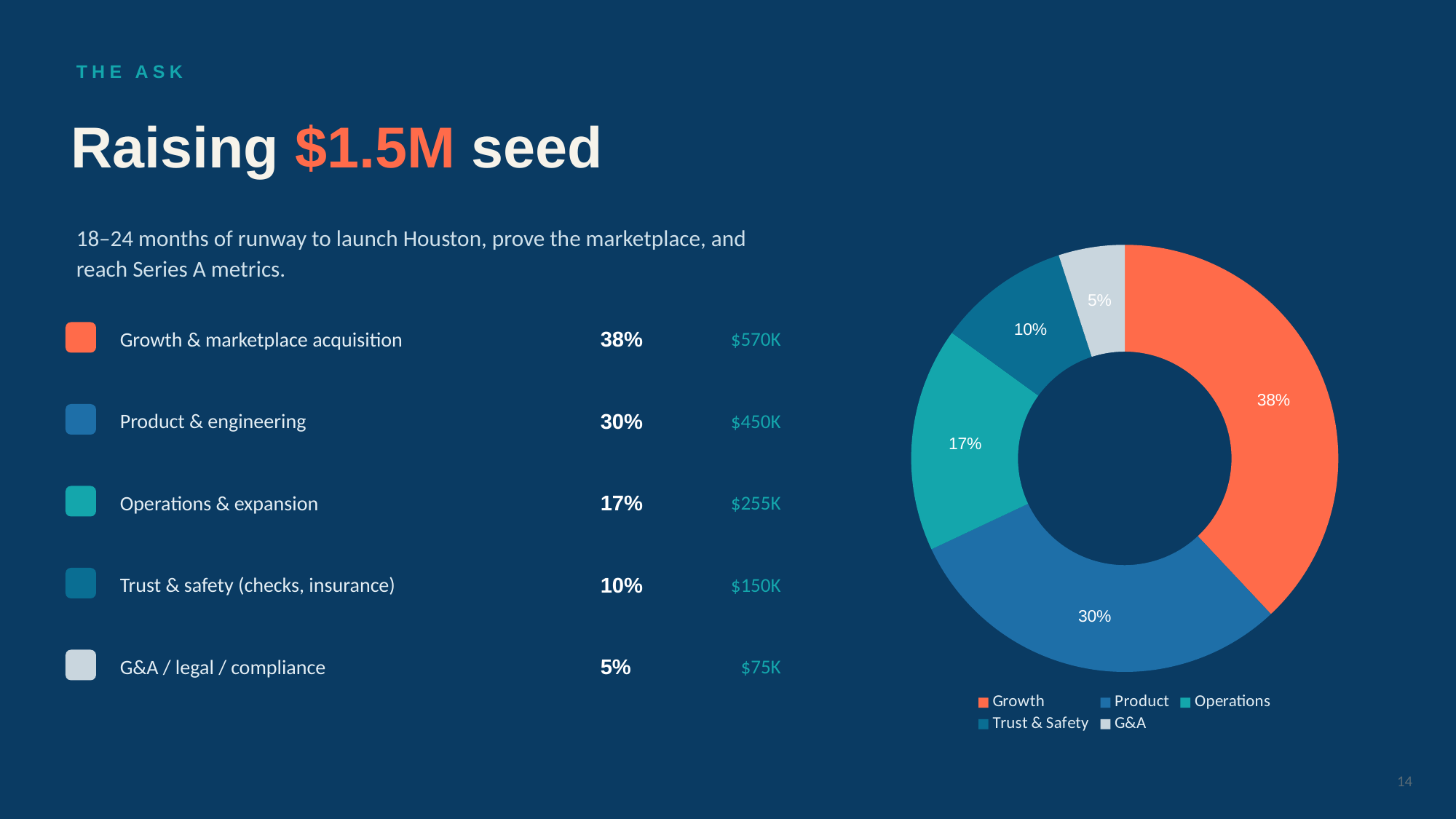
What kind of chart is shown on the slide? Pie chart What is the value shown for the Operations slice in the pie chart? 17% What is the difference in percentage points between the Growth and Product slices? 8% How many categories does the pie chart show? 5 Which category has the largest slice in the pie chart? Growth What share of the pie chart does the Growth slice represent? 38% Which category has the smallest slice in the pie chart? G&A What share of the pie chart does the Product slice represent? 30% Which slice is larger, Operations or Trust & Safety? Operations What colour is the Growth slice in the pie chart? Orange What is the value shown for the G&A slice in the pie chart? 5% What is the value shown for the Trust & Safety slice in the pie chart? 10%